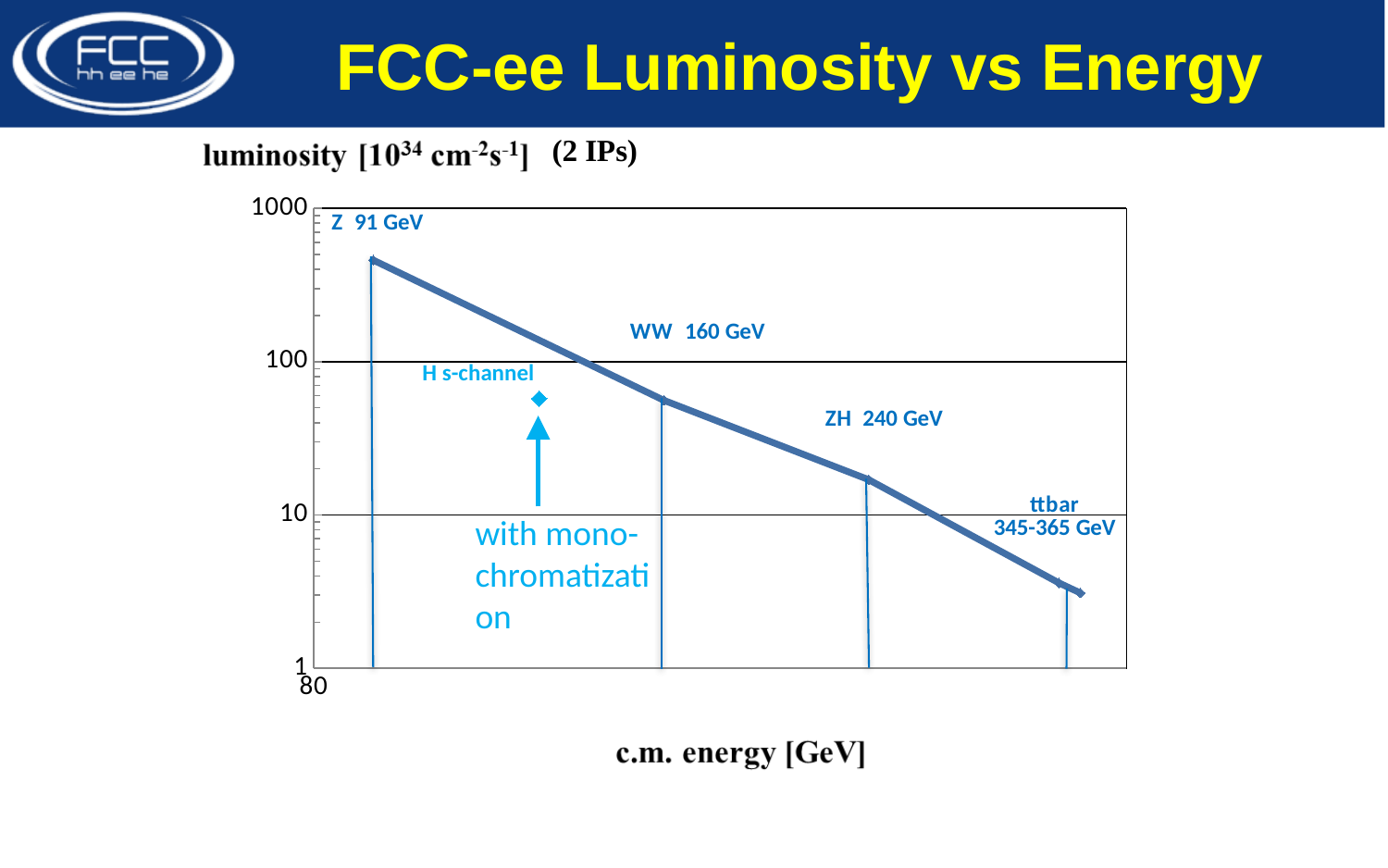
Is the luminosity at ttbar 345-365 GeV greater or less than 10? less Which has the higher luminosity, WW 160 GeV or ZH 240 GeV? WW 160 GeV Which labelled operating point has the highest luminosity? Z 91 GeV What kind of chart is shown on the slide? line chart Is the luminosity at Z 91 GeV greater or less than 100? greater Is the luminosity at ZH 240 GeV greater or less than 10? greater What is the title of the slide's chart? FCC-ee Luminosity vs Energy How many operating points are labelled on the main luminosity line (excluding the H s-channel point)? 4 Does the luminosity rise or fall as the c.m. energy increases along the x axis? fall What is the label of the x axis? c.m. energy [GeV] Which labelled operating point has the lowest luminosity? ttbar 345-365 GeV